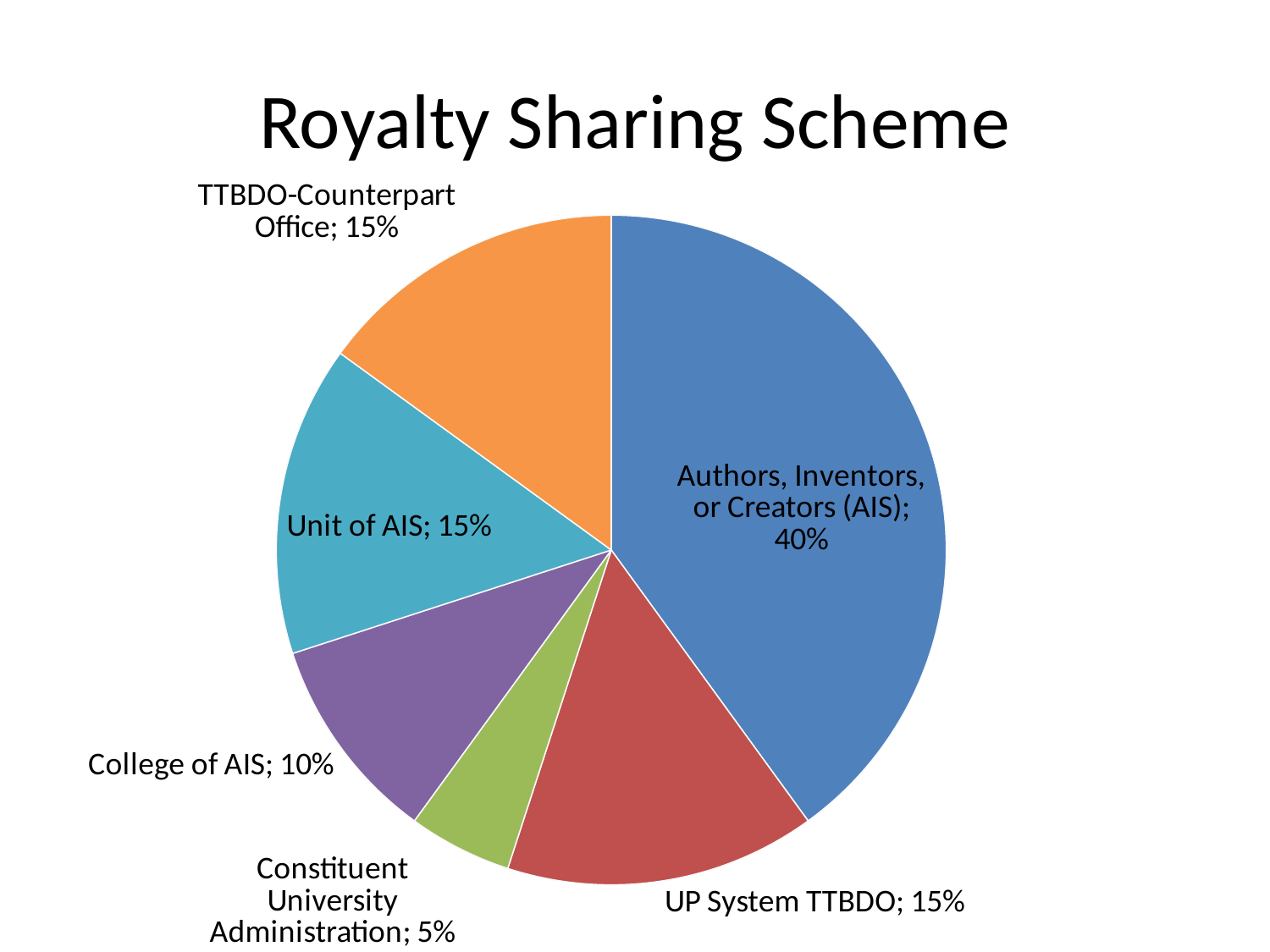
What colour is the slice for the Unit of AIS? Teal What share of royalties goes to the Constituent University Administration? 5% What is the title of the chart? Royalty Sharing Scheme Which receives a larger share: the College of AIS or the TTBDO-Counterpart Office? TTBDO-Counterpart Office Which category receives the smallest share of royalties? Constituent University Administration How many categories are shown in the pie chart? 6 What share of royalties goes to the UP System TTBDO? 15% What kind of chart is shown on the slide? Pie chart What share of royalties goes to Authors, Inventors, or Creators (AIS)? 40% Which category receives the largest share of royalties? Authors, Inventors, or Creators (AIS) What is the difference between the share for Authors, Inventors, or Creators (AIS) and the share for the Unit of AIS? 25% What share of royalties goes to the College of AIS? 10%